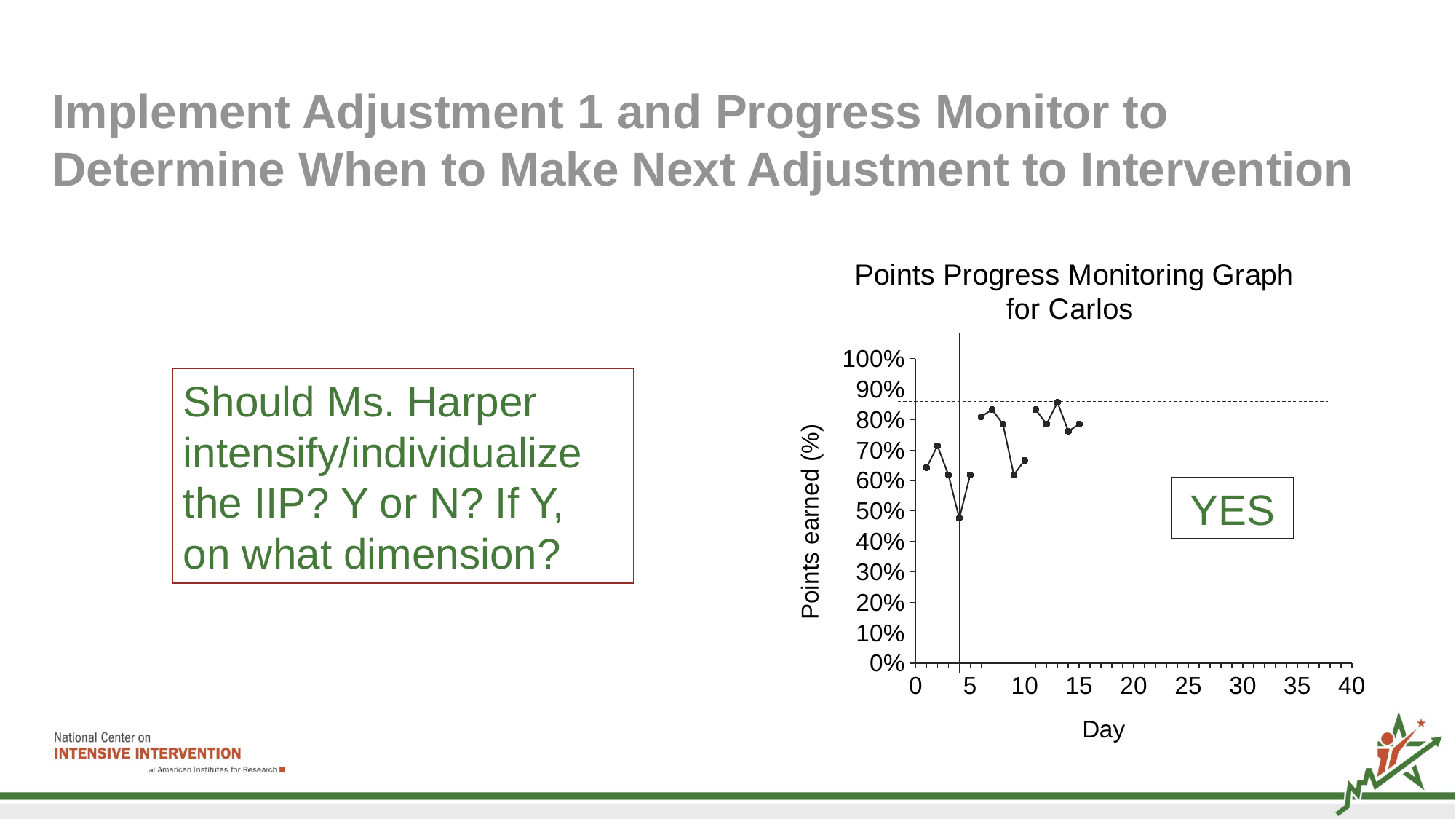
Do the values rise or fall from day 3 to day 4? Fall On which day is the lowest value plotted? Day 4 How many data points are plotted on the chart? 15 Is the value for day 9 greater or less than 70%? less What is the label of the y-axis of the chart? Points earned (%) What type of chart is shown on the slide? Line chart Which is larger, the value for day 4 or the value for day 13? Day 13 Is the value for day 4 greater or less than 60%? less What is the title of the chart? Points Progress Monitoring Graph for Carlos Is the value for day 13 greater or less than 80%? greater Which is larger, the value for day 7 or the value for day 9? Day 7